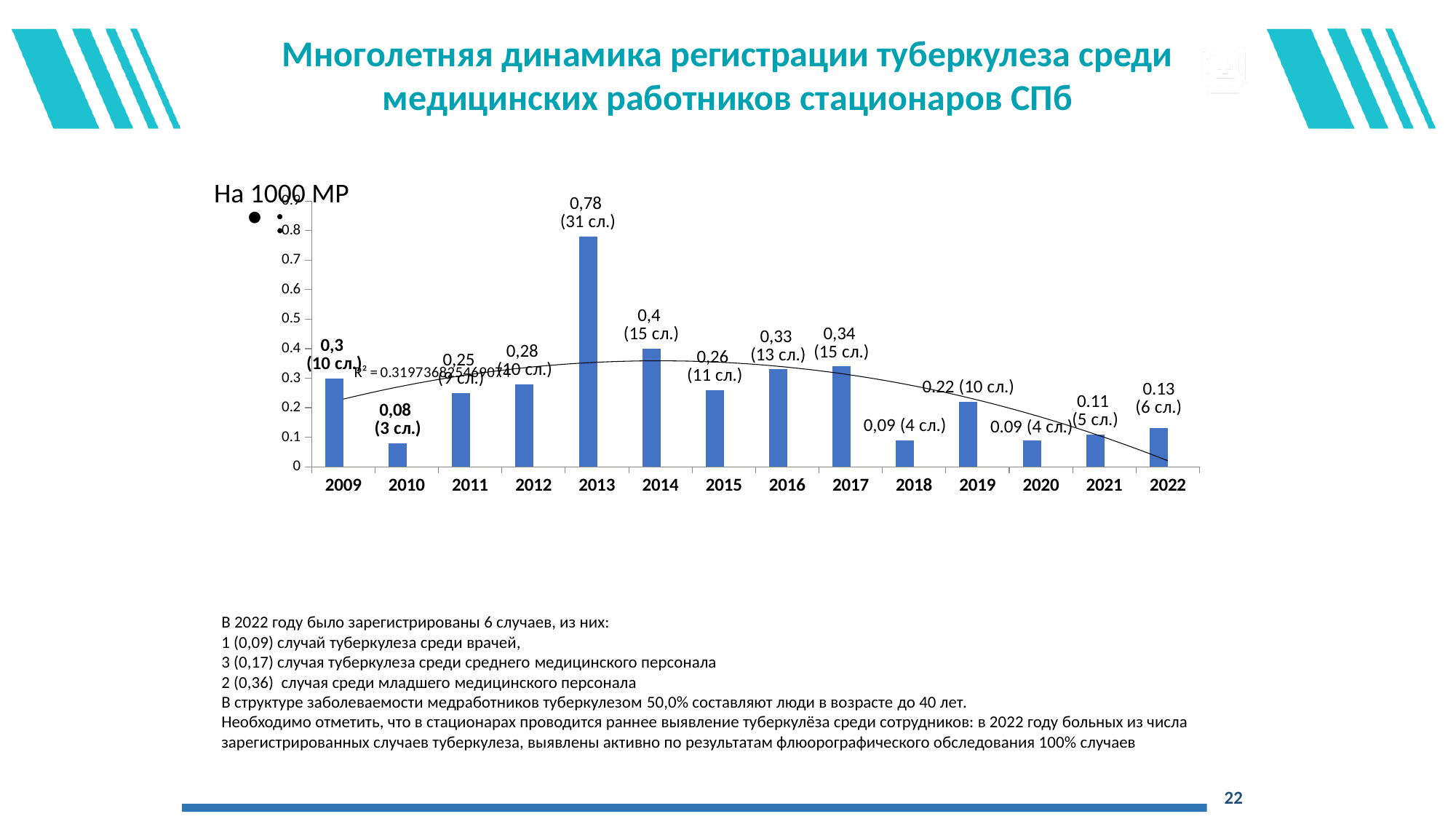
How many cases (сл.) are shown for 2013? 31 Is the value for 2013 greater or less than 0.7? greater How many years are shown on the x axis of the chart? 14 What is the value for 2022 on the chart? 0.13 Which year has the lowest value on the chart? 2010 Which year has the larger value, 2016 or 2017? 2017 What is the value for 2013 on the chart? 0,78 How many more cases were registered in 2013 than in 2014? 16 What is the difference between the values for 2013 and 2014? 0.38 Which year has the highest value on the chart? 2013 What kind of chart is shown on the slide? bar chart